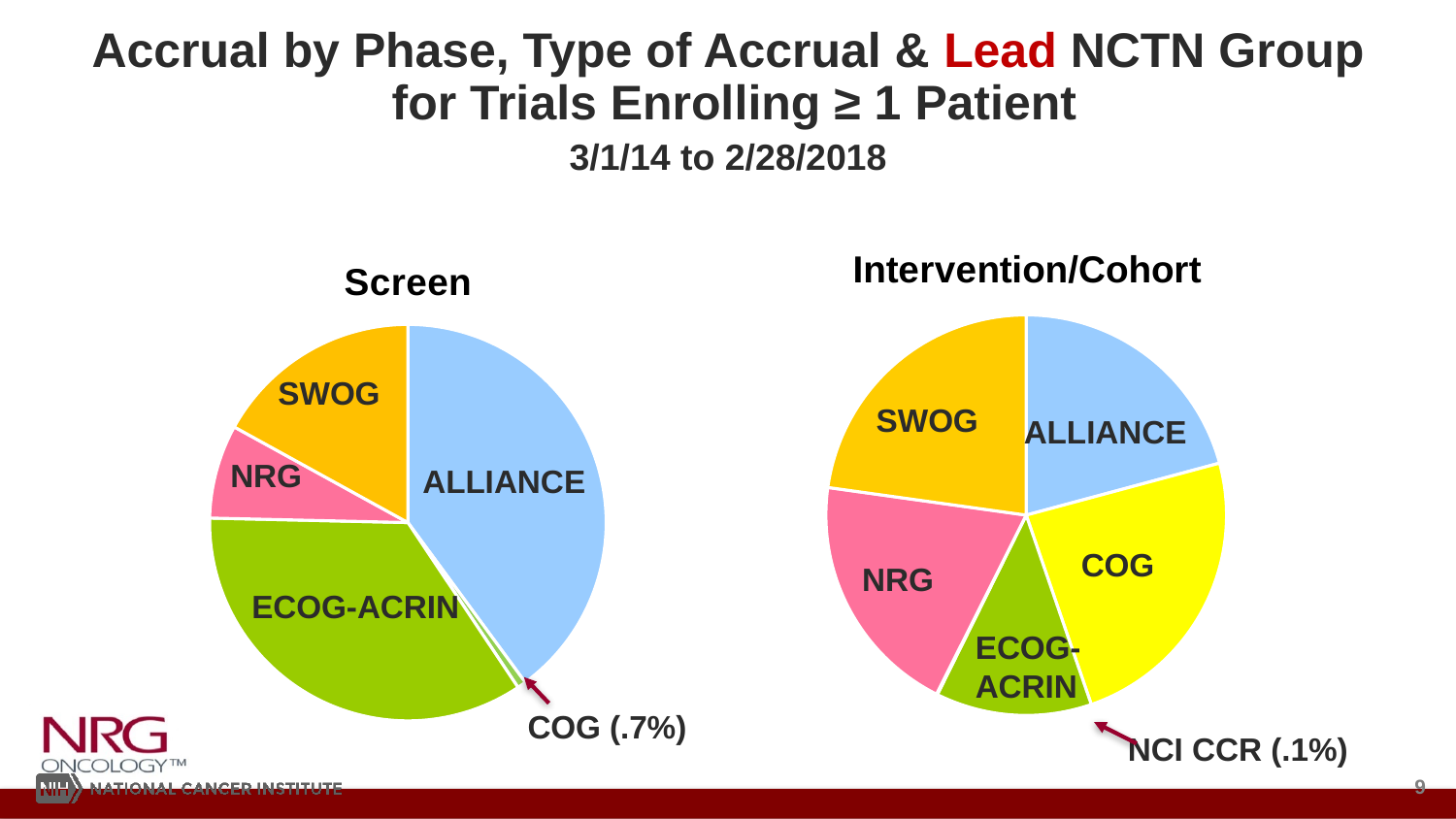
How many slices does the Screen chart have? 5 In the Intervention/Cohort chart, what share does NCI CCR have? .1% In the Screen chart, which group has the largest slice? ALLIANCE What is the title of the pie chart on the right side of the slide? Intervention/Cohort In the Intervention/Cohort chart, which is larger, the NRG slice or the ECOG-ACRIN slice? NRG In the Screen chart, which is larger, the ALLIANCE slice or the NRG slice? ALLIANCE In the Screen chart, which is larger, the ECOG-ACRIN slice or the SWOG slice? ECOG-ACRIN In the Screen chart, which group has the smallest slice? COG What type of chart is the Screen chart? Pie chart How many slices does the Intervention/Cohort chart have? 6 In the Screen chart, what share does COG have? .7% In the Intervention/Cohort chart, which group has the smallest slice? NCI CCR